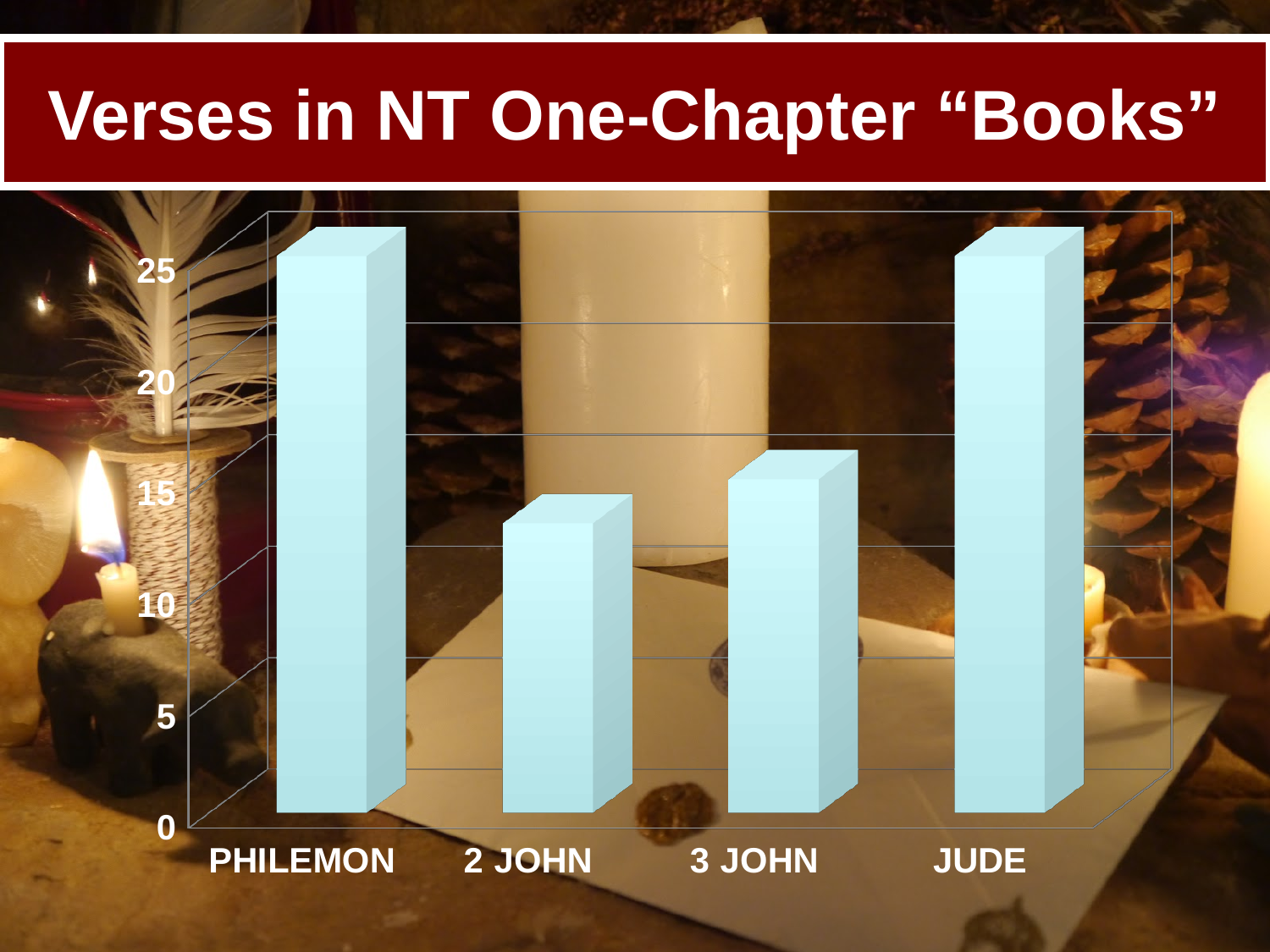
What kind of chart is shown on the slide? bar chart Which has the taller bar, Philemon or 2 John? Philemon Is the value for 2 John greater or less than 15? less What is the title of the chart? Verses in NT One-Chapter "Books" How many books (categories) are shown on the x axis? 4 Is the value for 3 John greater or less than 20? less Which book has the lowest bar? 2 John Is the value for 3 John greater or less than 10? greater Which has the taller bar, 2 John or 3 John? 3 John